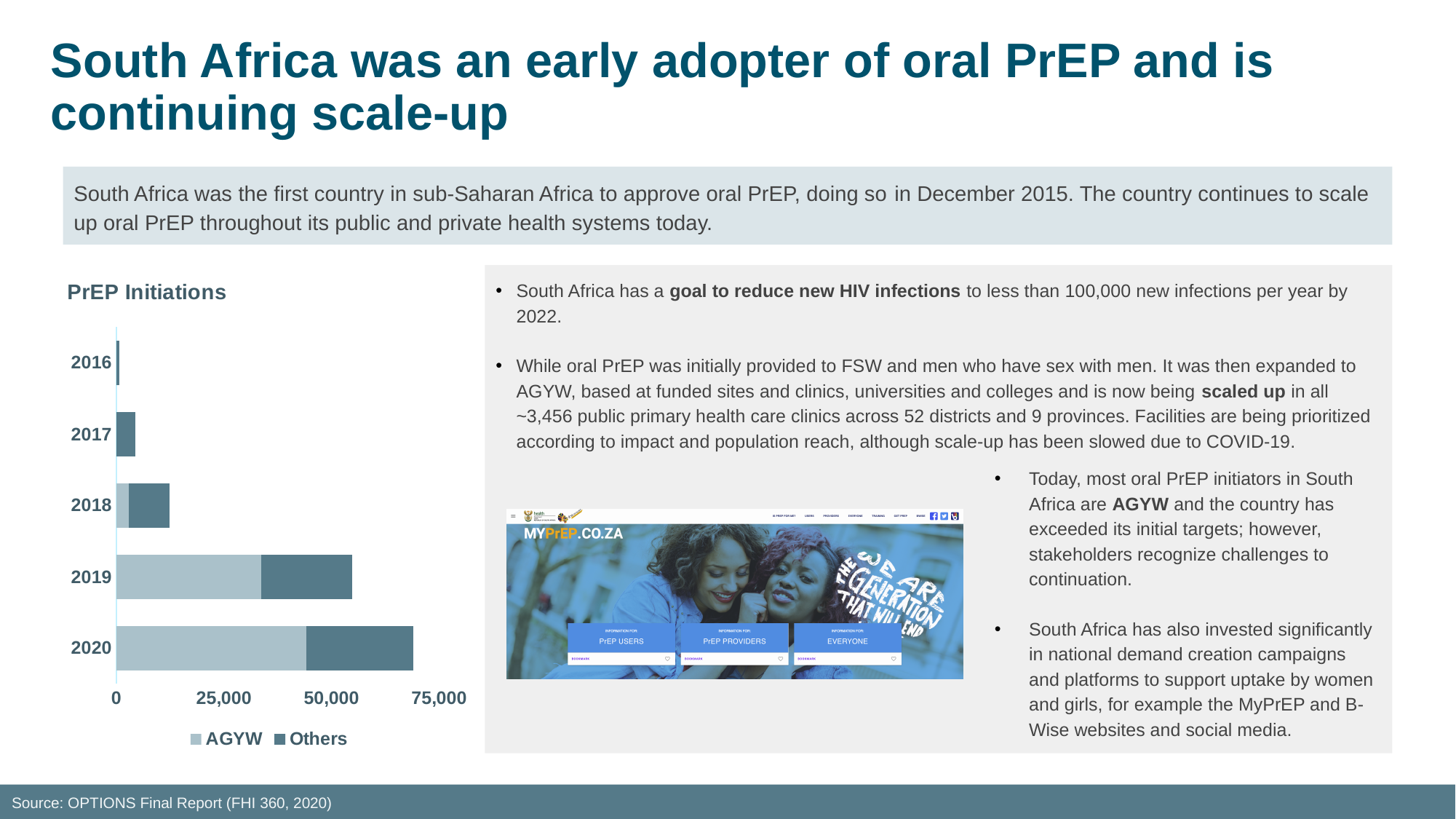
Is the total value for 2020 greater or less than 50,000? greater Is the total value for 2018 greater or less than 25,000? less Which two series are shown in the legend of the PrEP Initiations chart? AGYW and Others Do total PrEP initiations rise or fall from 2016 to 2020? Rise How many series does the legend of the PrEP Initiations chart list? 2 Is the AGYW value for 2019 greater or less than 25,000? greater Which year has more total PrEP initiations, 2019 or 2020? 2020 How many years are shown on the PrEP Initiations chart? 5 What type of chart is used to show PrEP Initiations? Bar chart What is the title of the chart on the slide? PrEP Initiations Which year has the lowest total PrEP initiations? 2016 Which year has the highest total PrEP initiations? 2020